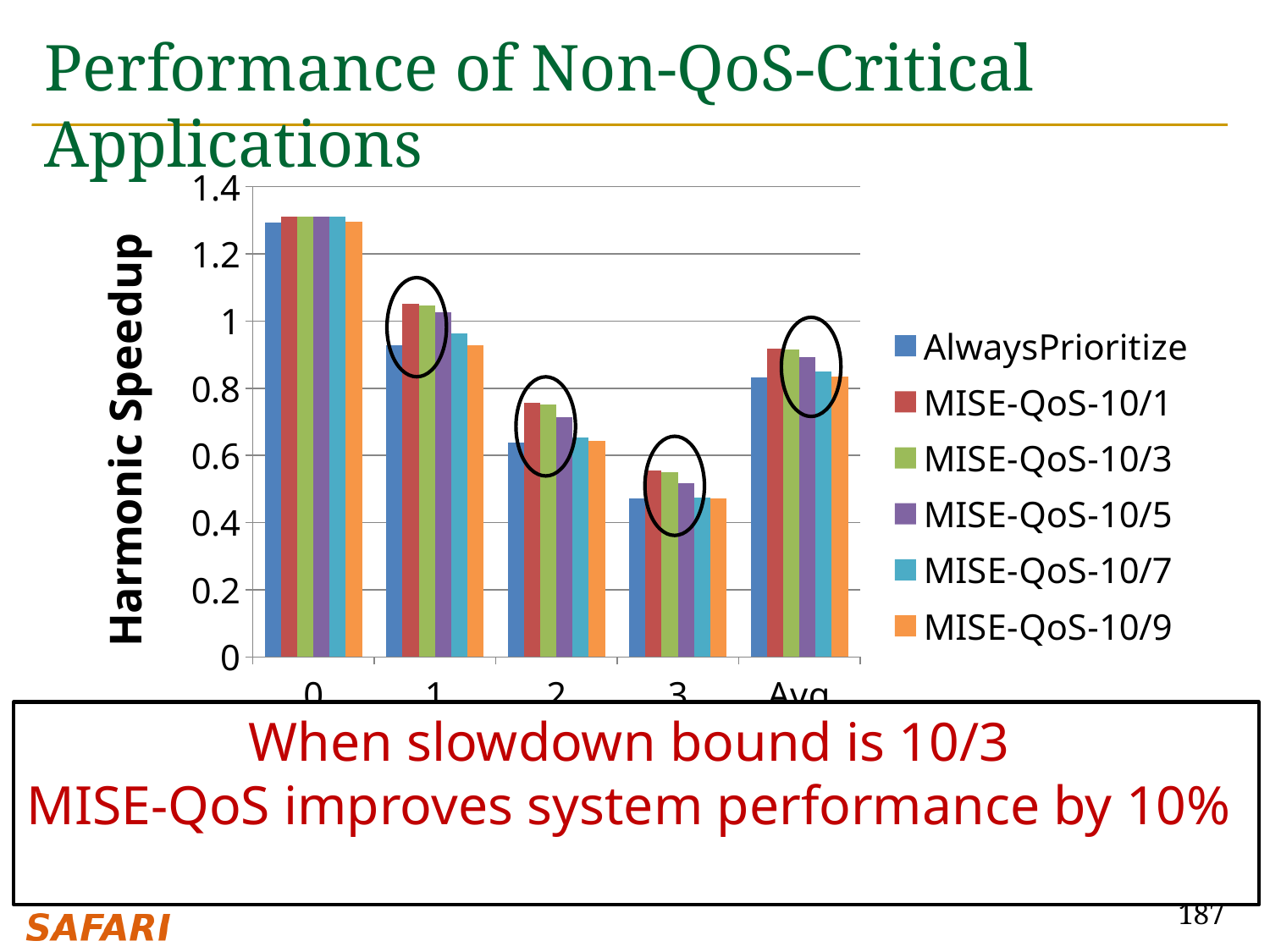
Which series is listed first in the legend? AlwaysPrioritize Do the AlwaysPrioritize values rise or fall from category 0 to category 3? fall What is the title of the y axis? Harmonic Speedup Is the AlwaysPrioritize value for category 3 greater or less than 0.6? less How many series does the legend list? 6 Is the AlwaysPrioritize value for category 0 greater or less than 1.2? greater For which category is the AlwaysPrioritize value lowest? 3 For category 2, which is larger: AlwaysPrioritize or MISE-QoS-10/1? MISE-QoS-10/1 How many categories are shown along the x axis? 5 What kind of chart is shown on the slide? bar chart Is the MISE-QoS-10/1 value for category 2 greater or less than 0.6? greater